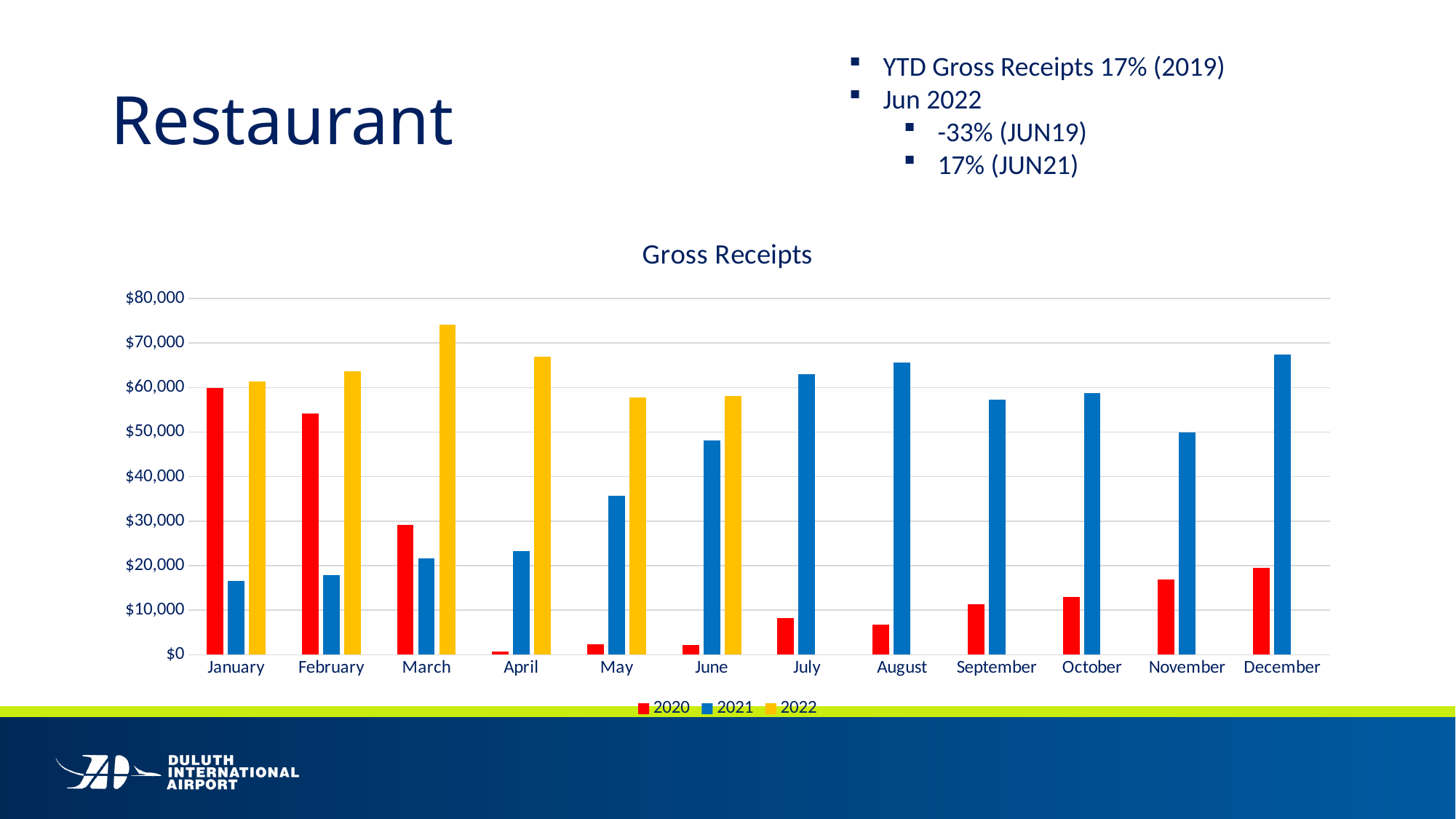
Is the 2021 value for January greater or less than $20,000? less Do the 2021 values rise or fall from January to June? rise Is the 2022 value for March greater or less than $70,000? greater How many months are shown along the x axis of the Gross Receipts chart? 12 How many series does the legend of the Gross Receipts chart list? 3 In which month is the 2022 gross receipts value highest? March Is the 2020 value for February greater or less than $50,000? greater What kind of chart is shown on the slide? Bar chart In June, which series has the larger value: 2021 or 2022? 2022 In which month is the 2020 gross receipts value lowest? April In January, which series has the larger value: 2020 or 2021? 2020 For how many months does the chart show a 2022 bar? 6